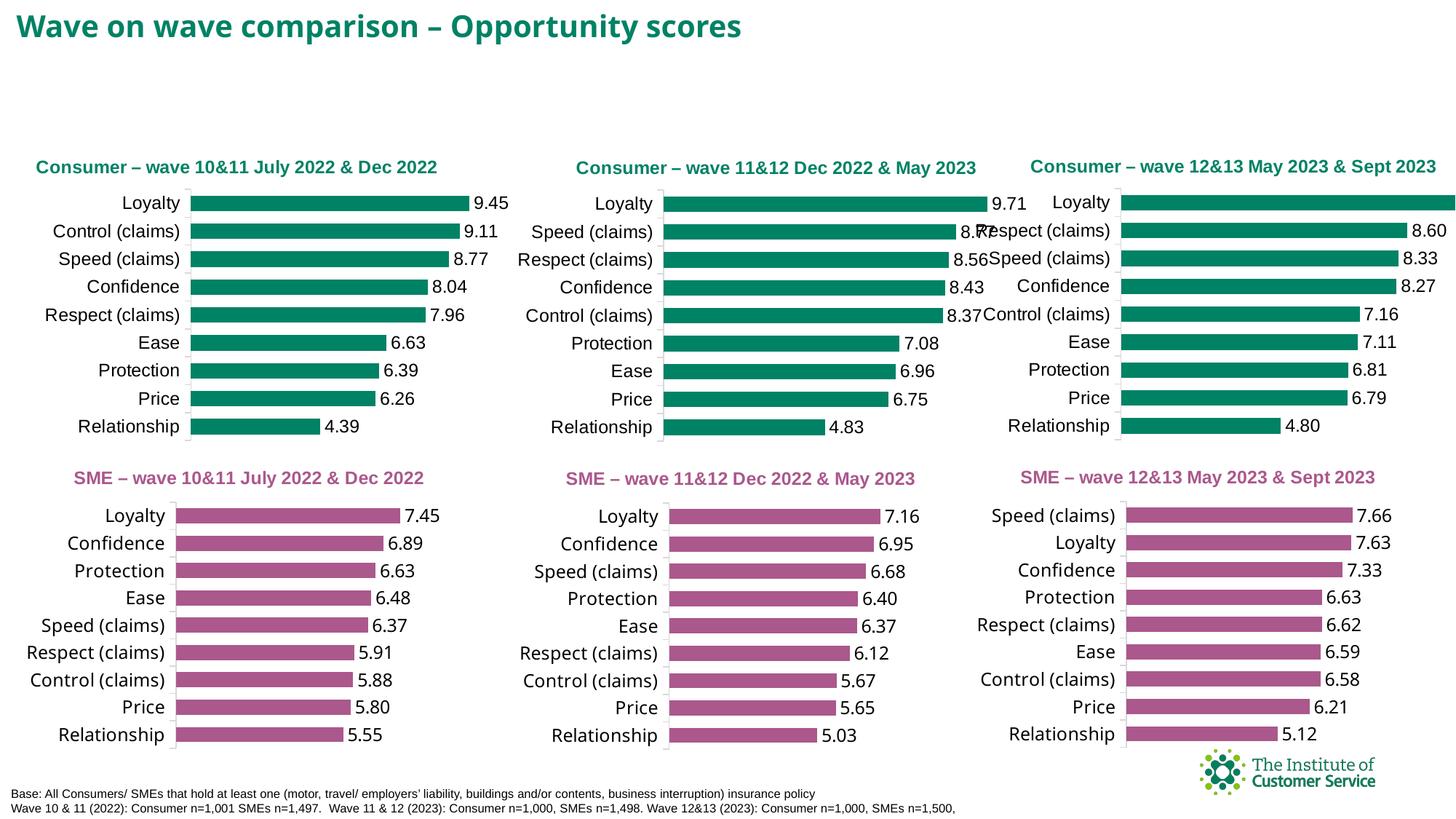
In the 'SME – wave 12&13 May 2023 & Sept 2023' chart, which category has the highest score? Speed (claims) In the 'SME – wave 10&11 July 2022 & Dec 2022' chart, what is the score for Price? 5.80 In the 'Consumer – wave 12&13 May 2023 & Sept 2023' chart, what is the score for Respect (claims)? 8.60 In the 'Consumer – wave 12&13 May 2023 & Sept 2023' chart, which is larger, the score for Ease or the score for Protection? Ease In the 'Consumer – wave 10&11 July 2022 & Dec 2022' chart, which category has the lowest score? Relationship In the 'SME – wave 11&12 Dec 2022 & May 2023' chart, what is the score for Speed (claims)? 6.68 In the 'Consumer – wave 11&12 Dec 2022 & May 2023' chart, what is the difference between the Loyalty score and the Relationship score? 4.88 In the 'Consumer – wave 10&11 July 2022 & Dec 2022' chart, what is the opportunity score for Loyalty? 9.45 In the 'SME – wave 12&13 May 2023 & Sept 2023' chart, what is the difference between the Confidence score and the Relationship score? 2.21 In the 'SME – wave 10&11 July 2022 & Dec 2022' chart, which category has the highest score? Loyalty In the 'Consumer – wave 11&12 Dec 2022 & May 2023' chart, what is the score for Confidence? 8.43 How many categories are plotted in the 'SME – wave 11&12 Dec 2022 & May 2023' chart? 9